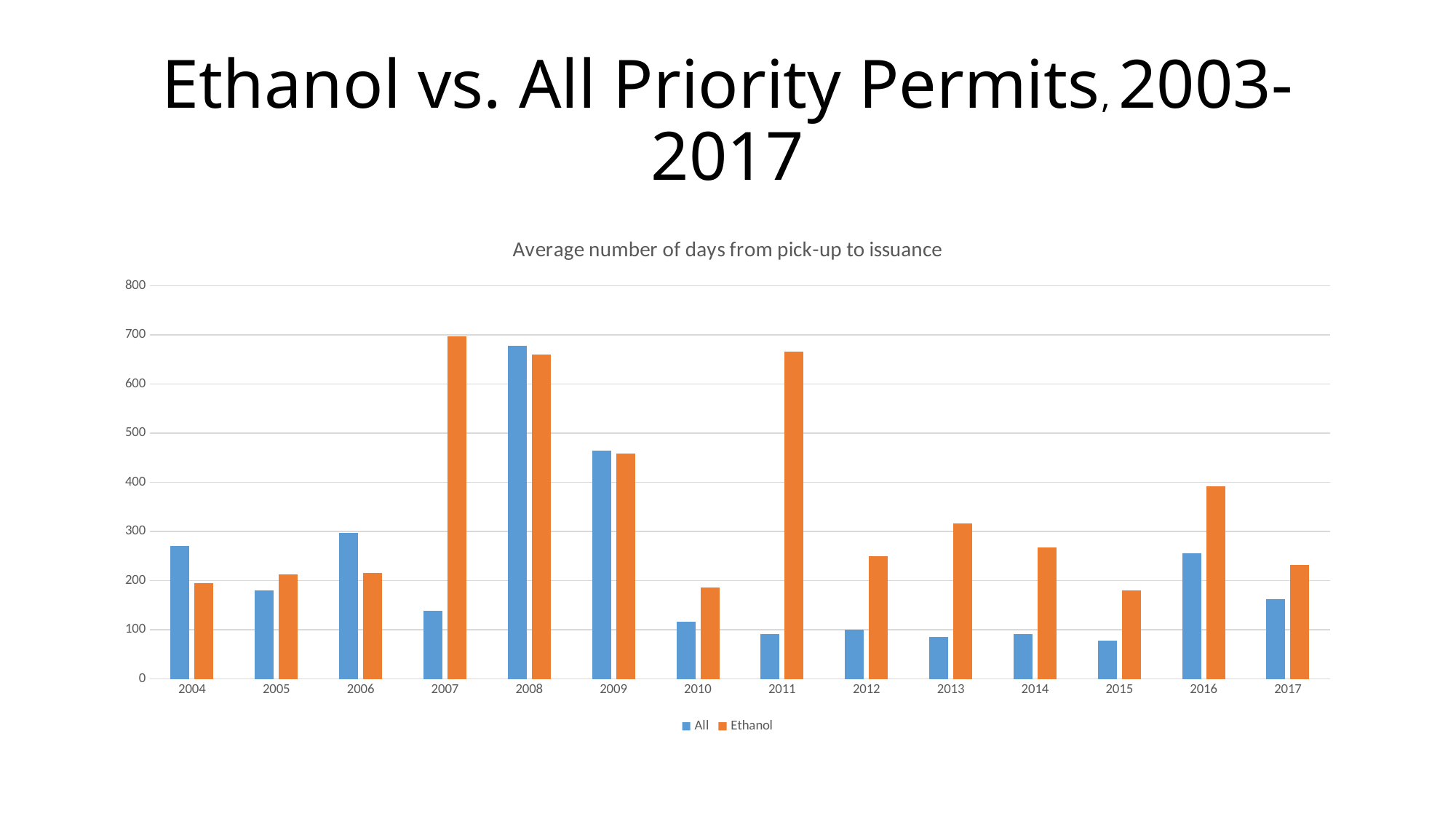
How many series does the legend list? 2 Is the value for All in 2007 greater or less than 200? less In 2004, which series has the larger value, All or Ethanol? All Is the value for Ethanol in 2016 greater or less than 300? greater Is the value for Ethanol in 2011 greater or less than 600? greater What kind of chart is shown on the slide? bar chart In 2012, which series has the larger value, All or Ethanol? Ethanol In which year is the value for All highest? 2008 Does the value for All rise or fall from 2008 to 2011? fall How many years are shown on the x axis? 14 In which year is the value for Ethanol highest? 2007